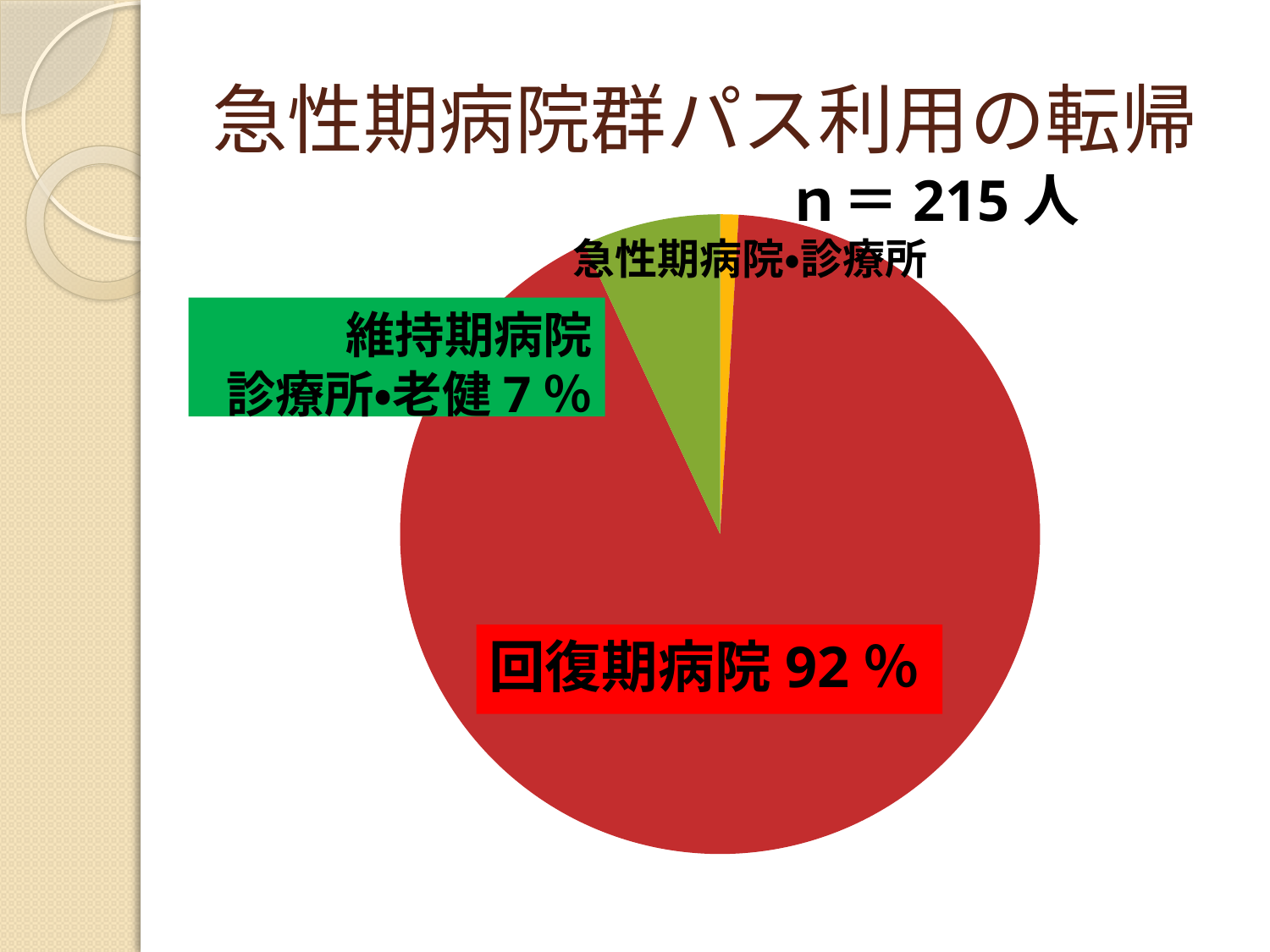
What colour is the slice for 回復期病院? Red How many slices does the pie chart have? 3 Which category has the largest slice of the pie? 回復期病院 Which category has the smallest slice of the pie? 急性期病院・診療所 By how many percentage points does 回復期病院 exceed 維持期病院・診療所・老健? 85 percentage points What kind of chart is shown on the slide? Pie chart What is the sample size (n) shown on the slide? 215人 Is the share for 回復期病院 greater or less than 50%? greater What share of the pie does 回復期病院 account for? 92％ Which is larger, the slice for 回復期病院 or the slice for 維持期病院・診療所・老健? 回復期病院 What percentage is shown for 維持期病院・診療所・老健? 7％